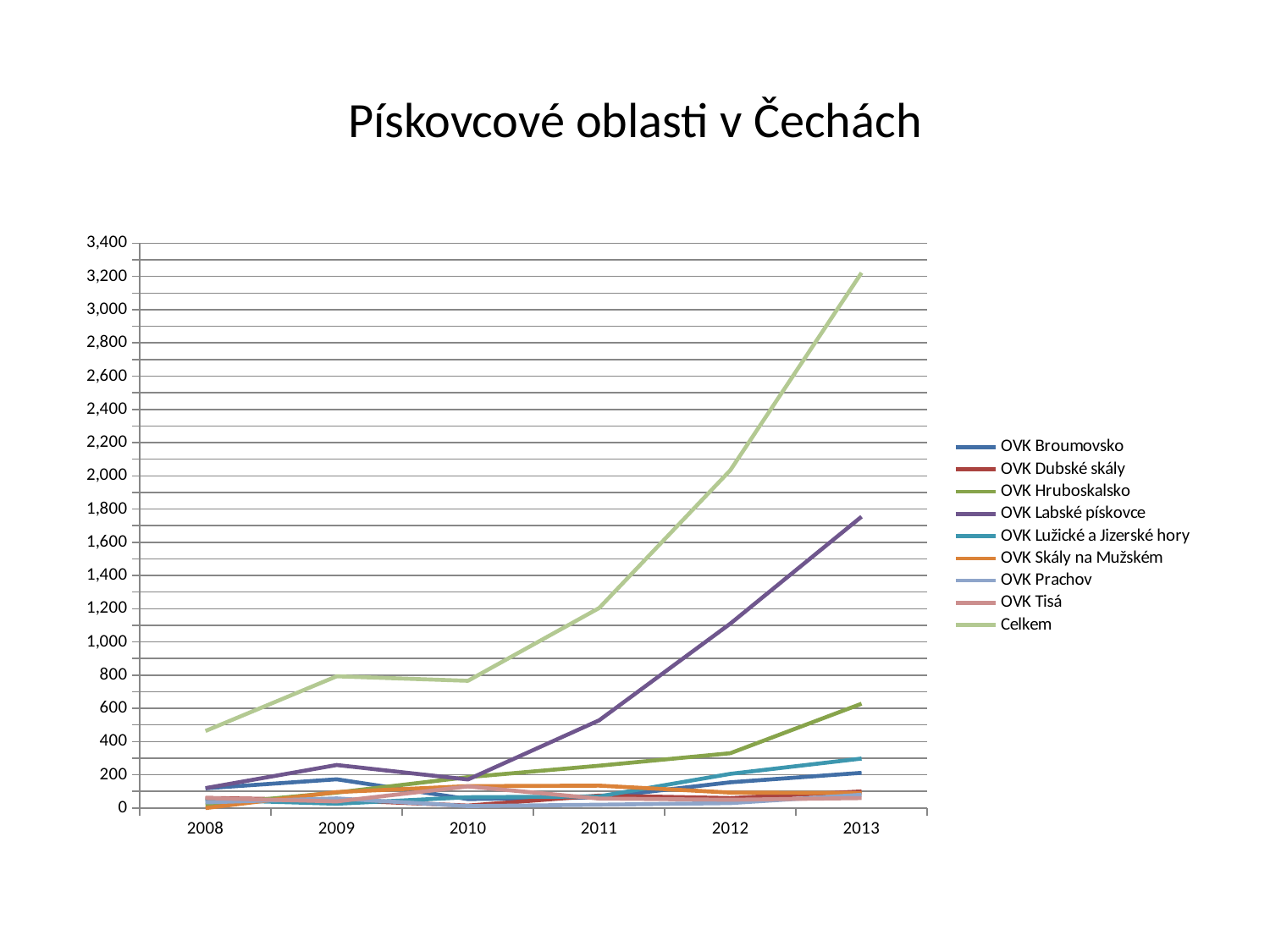
In 2013, which is larger: OVK Labské pískovce or OVK Hruboskalsko? OVK Labské pískovce Is the value for Celkem in 2013 greater or less than 3,000? greater Does the Celkem line rise or fall from 2010 to 2013? rises Which series has the highest value in 2013? Celkem How many series does the legend list? 9 What is the title of the slide? Pískovcové oblasti v Čechách Is the value for Celkem in 2008 greater or less than 600? less Is the value for OVK Labské pískovce in 2013 greater or less than 1,600? greater How many years are shown on the x axis? 6 What kind of chart is shown on the slide? line chart Does the OVK Labské pískovce line rise or fall from 2010 to 2013? rises